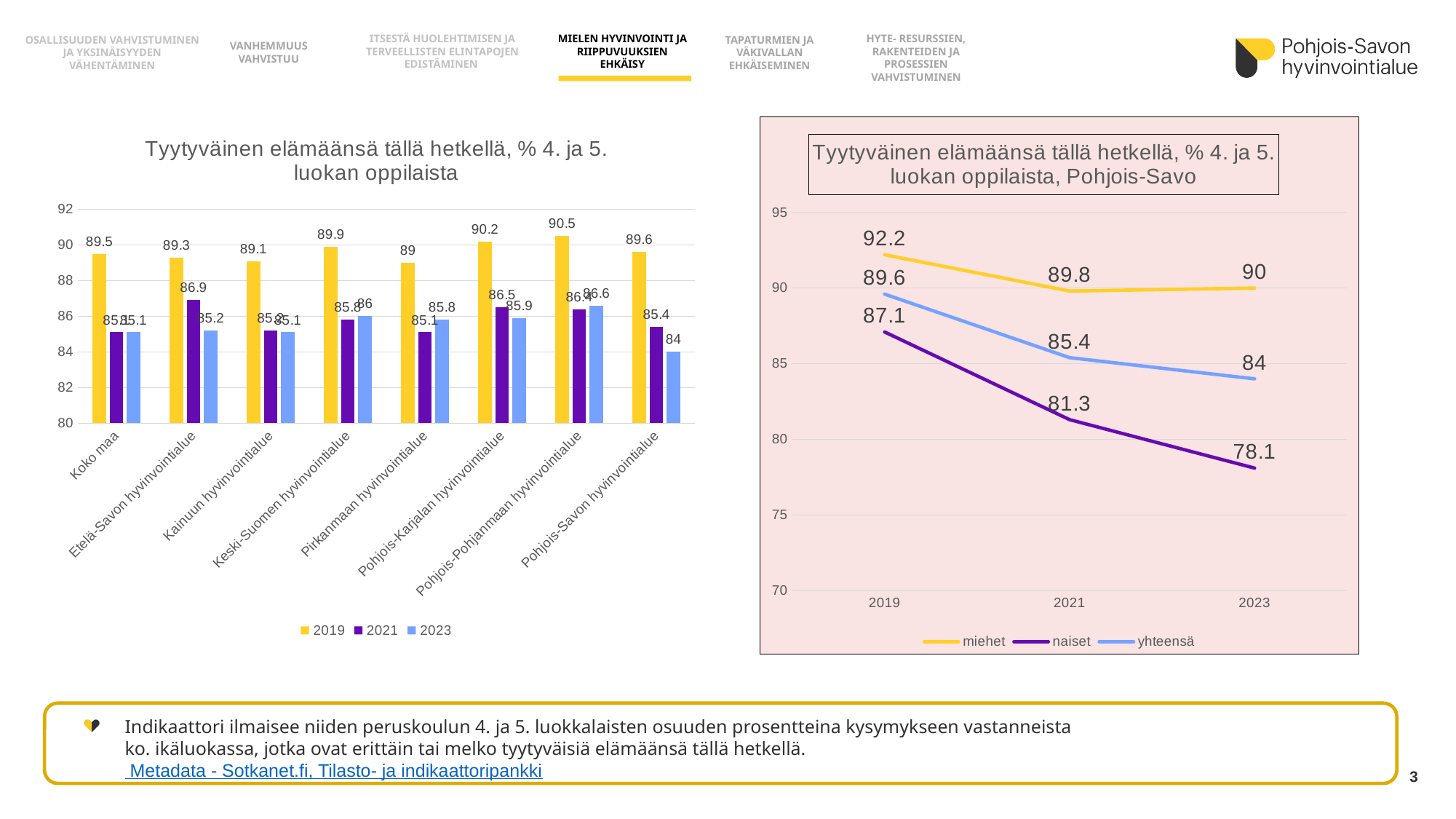
In the right line chart (Pohjois-Savo), which series is higher in 2019, miehet or yhteensä? miehet In the left bar chart, which category has the lowest 2023 value? Pohjois-Savon hyvinvointialue In the left bar chart, how many categories are shown on the x axis? 8 What kind of chart is the chart on the left of the slide? Bar chart In the right line chart (Pohjois-Savo), what is the value for naiset in 2021? 81.3 In the left bar chart, what is the 2023 value for Pohjois-Savon hyvinvointialue? 84 In the right line chart (Pohjois-Savo), what is the difference between miehet and naiset in 2023? 11.9 In the left bar chart, what is the difference between the 2019 and 2023 values for Pohjois-Savon hyvinvointialue? 5.6 In the left bar chart, which category has the highest 2019 value? Pohjois-Pohjanmaan hyvinvointialue In the left bar chart, what is the 2019 value for Pohjois-Pohjanmaan hyvinvointialue? 90.5 In the right line chart (Pohjois-Savo), do the values for naiset rise or fall from 2019 to 2023? Fall In the left bar chart, how many series does the legend list? 3